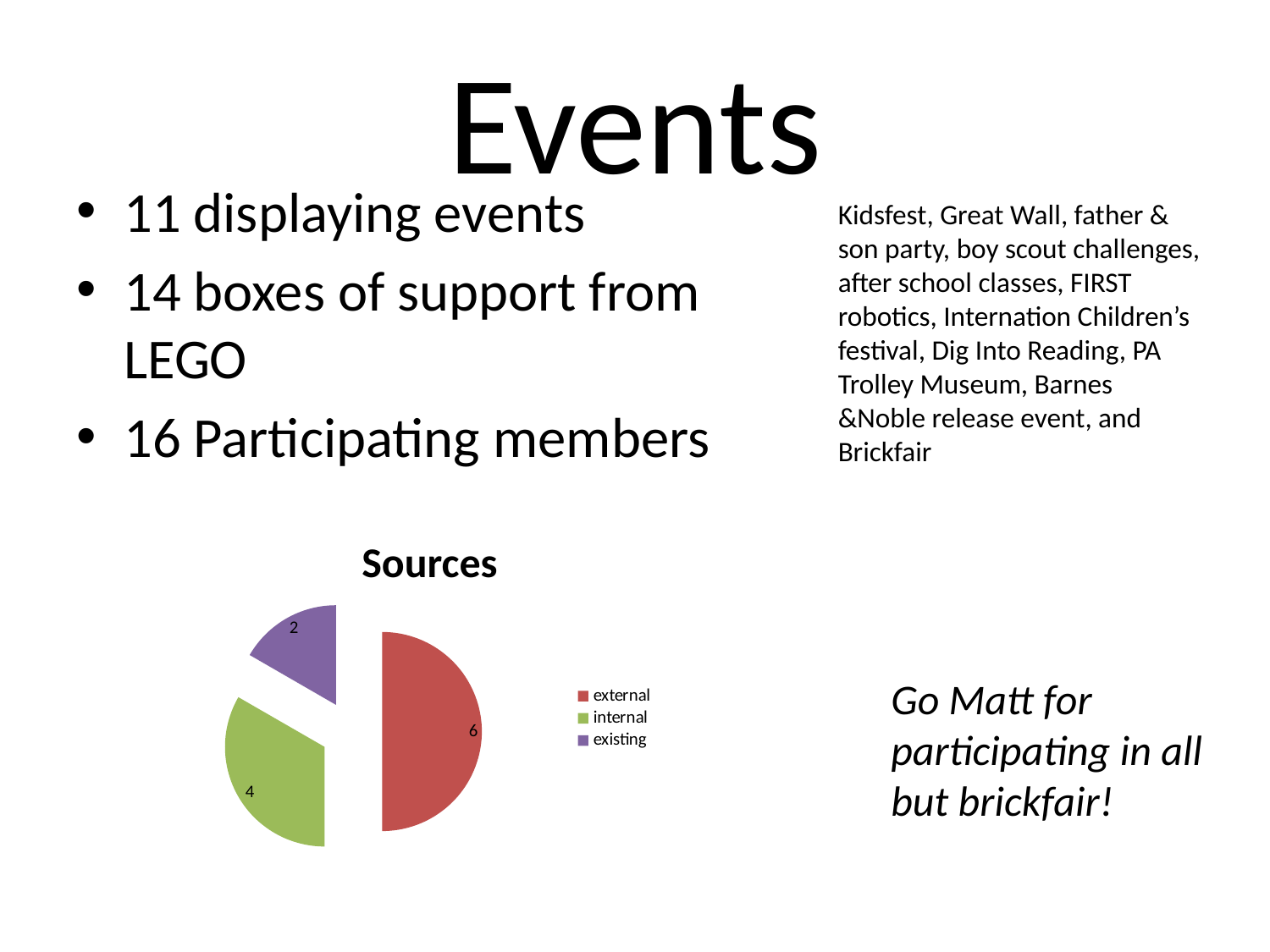
What kind of chart is shown under the title "Sources"? pie chart How many entries does the legend of the Sources pie chart list? 3 What share of the Sources pie chart does the "external" slice represent? 50% What is the value of the "existing" slice in the Sources pie chart? 2 What is the value of the "internal" slice in the Sources pie chart? 4 Which category has the largest slice in the Sources pie chart? external What is the title of the chart on the slide? Sources How many slices does the Sources pie chart have? 3 In the Sources pie chart, which is larger: internal or existing? internal In the Sources pie chart, what is the difference between the external and internal values? 2 What is the value of the "external" slice in the Sources pie chart? 6 Which category has the smallest slice in the Sources pie chart? existing